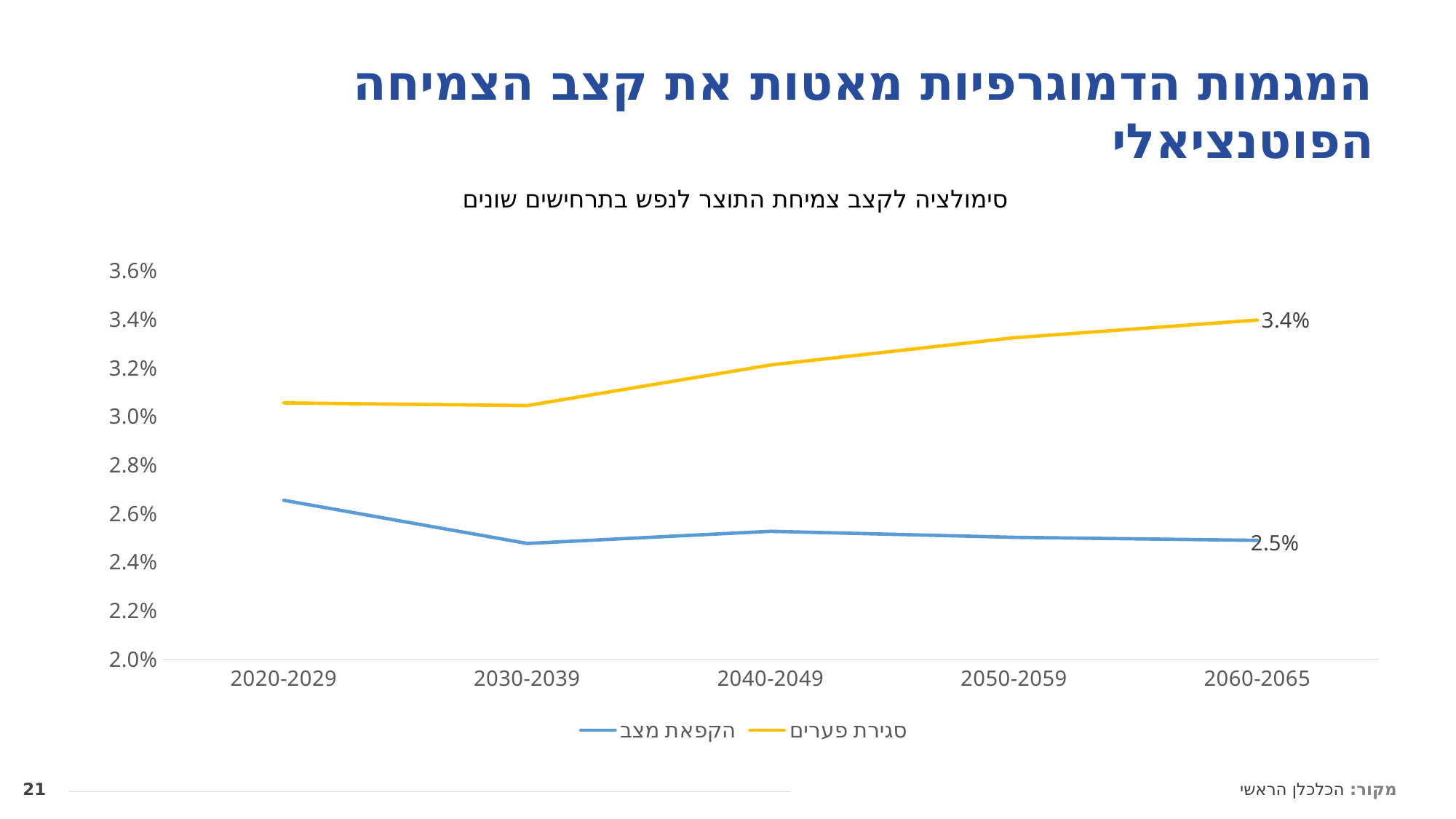
How many periods are shown on the x axis? 5 Which series has the higher value for 2060-2065, סגירת פערים or הקפאת מצב? סגירת פערים How many series does the legend list? 2 What is the difference between the two series' values for 2060-2065? 0.9% What is the value of the הקפאת מצב series for 2060-2065? 2.5% What is the value of the סגירת פערים series for 2060-2065? 3.4% What kind of chart is shown on the slide? line chart Does the סגירת פערים series rise or fall from 2030-2039 to 2060-2065? rise What colour is the line for the סגירת פערים series? yellow Is the value of the סגירת פערים series for 2020-2029 greater or less than 3.0%? greater Is the value of the הקפאת מצב series for 2030-2039 greater or less than 2.6%? less Does the הקפאת מצב series rise or fall from 2020-2029 to 2030-2039? fall